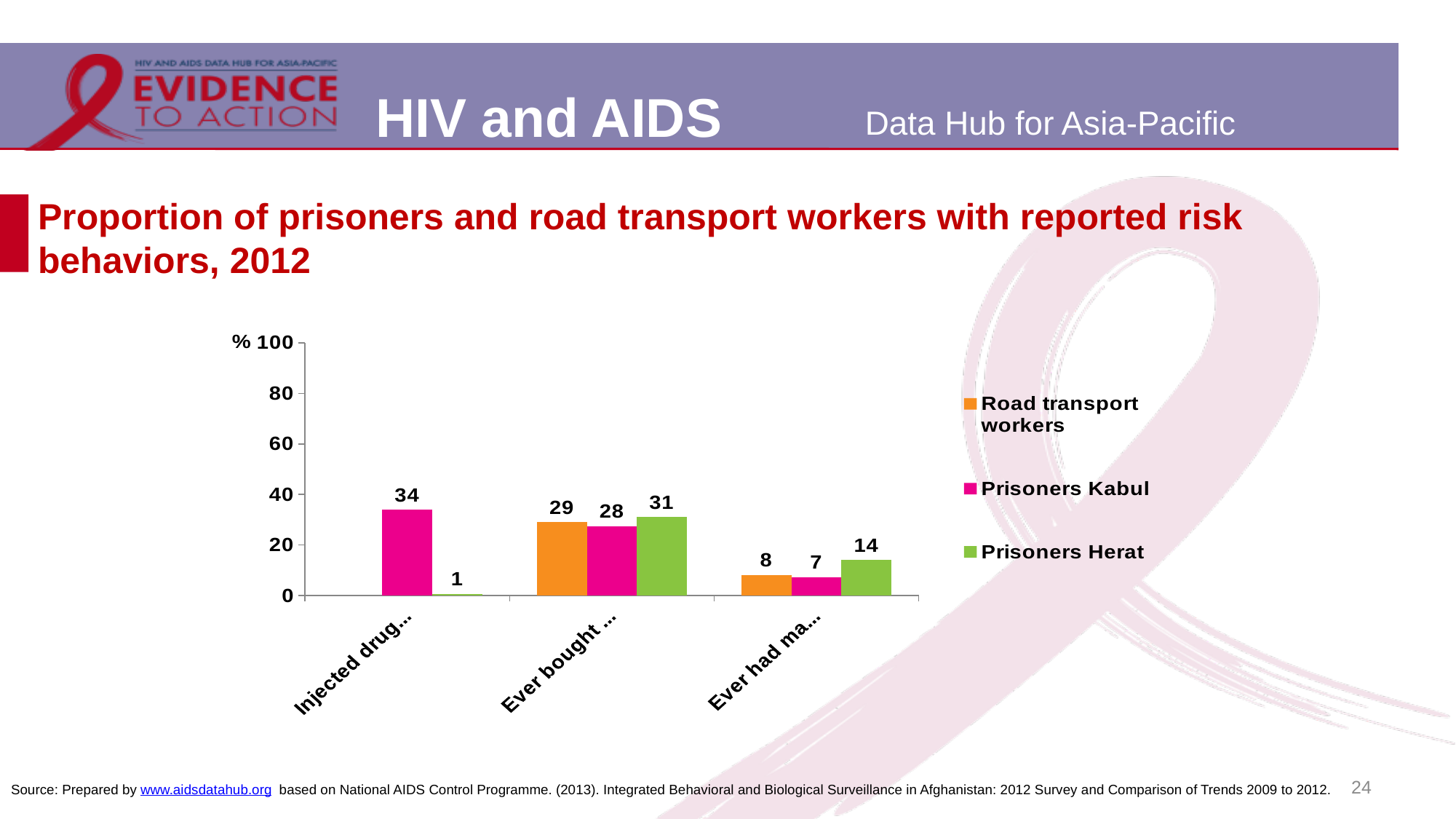
How many series does the legend list? 3 What kind of chart is shown on the slide? bar chart What is the value for Prisoners Kabul in the first category (labelled "Injected drug...")? 34 Is the value for Prisoners Kabul in the first category (labelled "Injected drug...") greater or less than 20? greater In the third category (labelled "Ever had ma..."), how much higher is Prisoners Herat than Prisoners Kabul? 7 What is the value for Prisoners Herat in the category labelled "Ever bought ..."? 31 How many categories are shown on the x axis? 3 In the first category (labelled "Injected drug..."), what is the difference between Prisoners Kabul and Prisoners Herat? 33 What is the value for Road transport workers in the third category (labelled "Ever had ma...")? 8 Which series has the highest value in the category labelled "Ever bought ..."? Prisoners Herat In the category labelled "Ever bought ...", which is larger: Road transport workers or Prisoners Kabul? Road transport workers Which series has the lowest value in the third category (labelled "Ever had ma...")? Prisoners Kabul